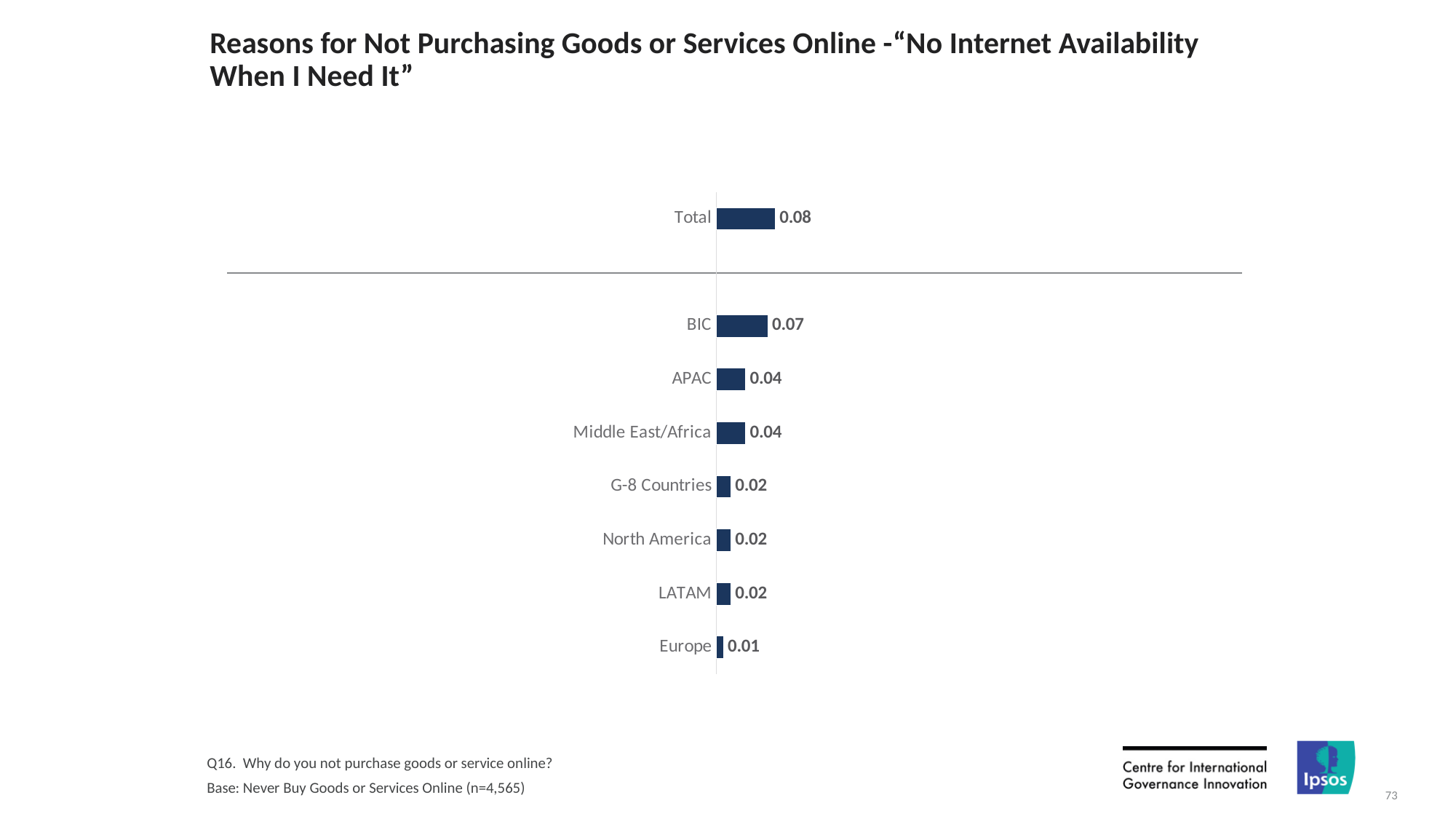
What kind of chart is shown on the slide? Bar chart How many bars are shown in the chart, including Total? 8 What is the value for BIC? 0.07 Which region has the highest value, excluding Total? BIC Which is larger, the value for BIC or the value for North America? BIC What is the value for Total? 0.08 What is the difference between the values for Total and Europe? 0.07 What is the difference between the values for BIC and APAC? 0.03 What is the value for Europe? 0.01 Which region has the lowest value? Europe What is the base sample size (n) stated at the bottom of the slide? n=4,565 What is the value for Middle East/Africa? 0.04